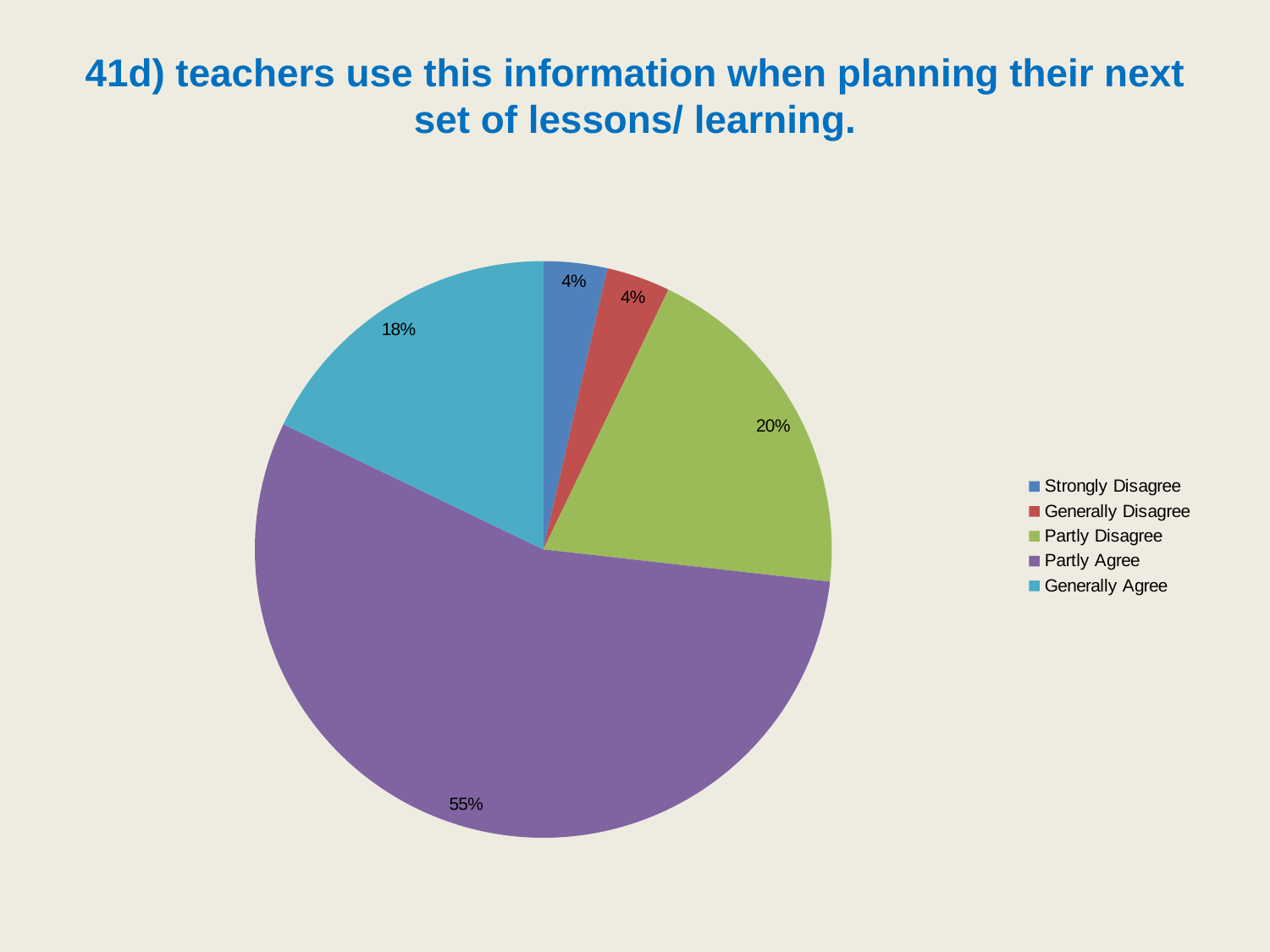
What share of the pie is Partly Agree? 55% What colour is the Partly Agree slice? purple What share of the pie is Partly Disagree? 20% Which is larger, the Partly Disagree slice or the Generally Agree slice? Partly Disagree What is the difference between the Partly Agree share and the Partly Disagree share? 35% What share of the pie is Generally Agree? 18% Which category has the largest slice of the pie? Partly Agree What kind of chart is shown on the slide? pie chart What is the title of the chart? 41d) teachers use this information when planning their next set of lessons/ learning. What is the difference between the Generally Agree share and the Generally Disagree share? 14% How many categories does the legend list? 5